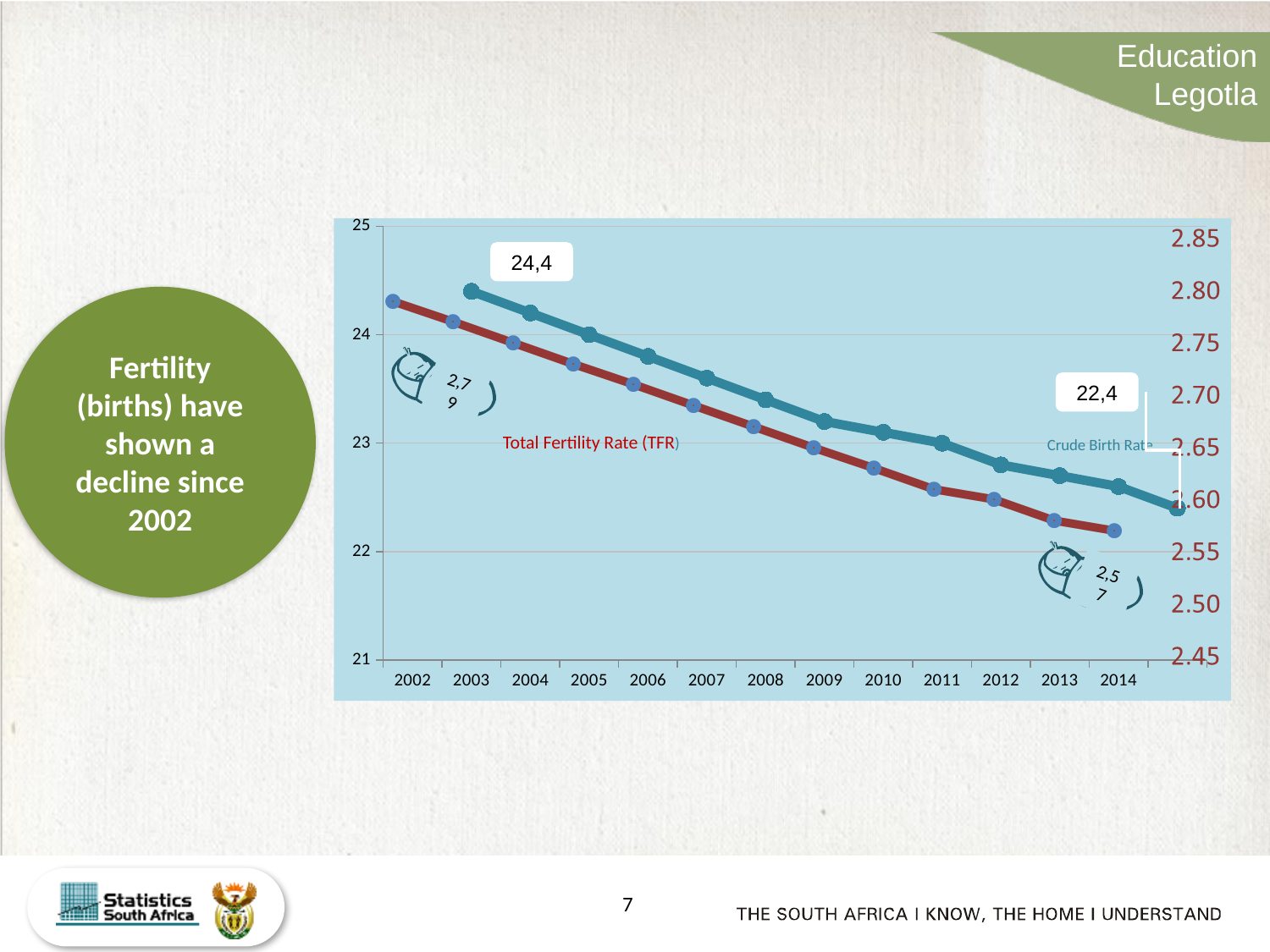
How many years are shown along the x axis of the chart? 13 What is the labelled value of the Crude Birth Rate in 2003? 24,4 What kind of chart is shown on the slide? line chart Is the Crude Birth Rate value for 2006 greater or less than 24 on the left axis? less Do the values of the Crude Birth Rate rise or fall from 2002 to 2014? fall What is the labelled Total Fertility Rate (TFR) at the start of the series in 2002? 2,79 What is the labelled Total Fertility Rate (TFR) at the end of the series in 2014? 2,57 What colour is the Total Fertility Rate (TFR) line on the chart? red By how much did the labelled Crude Birth Rate fall between 2003 (24,4) and 2014 (22,4)? 2,0 Is the Crude Birth Rate value for 2012 greater or less than 23 on the left axis? less How many series are plotted on the chart? 2